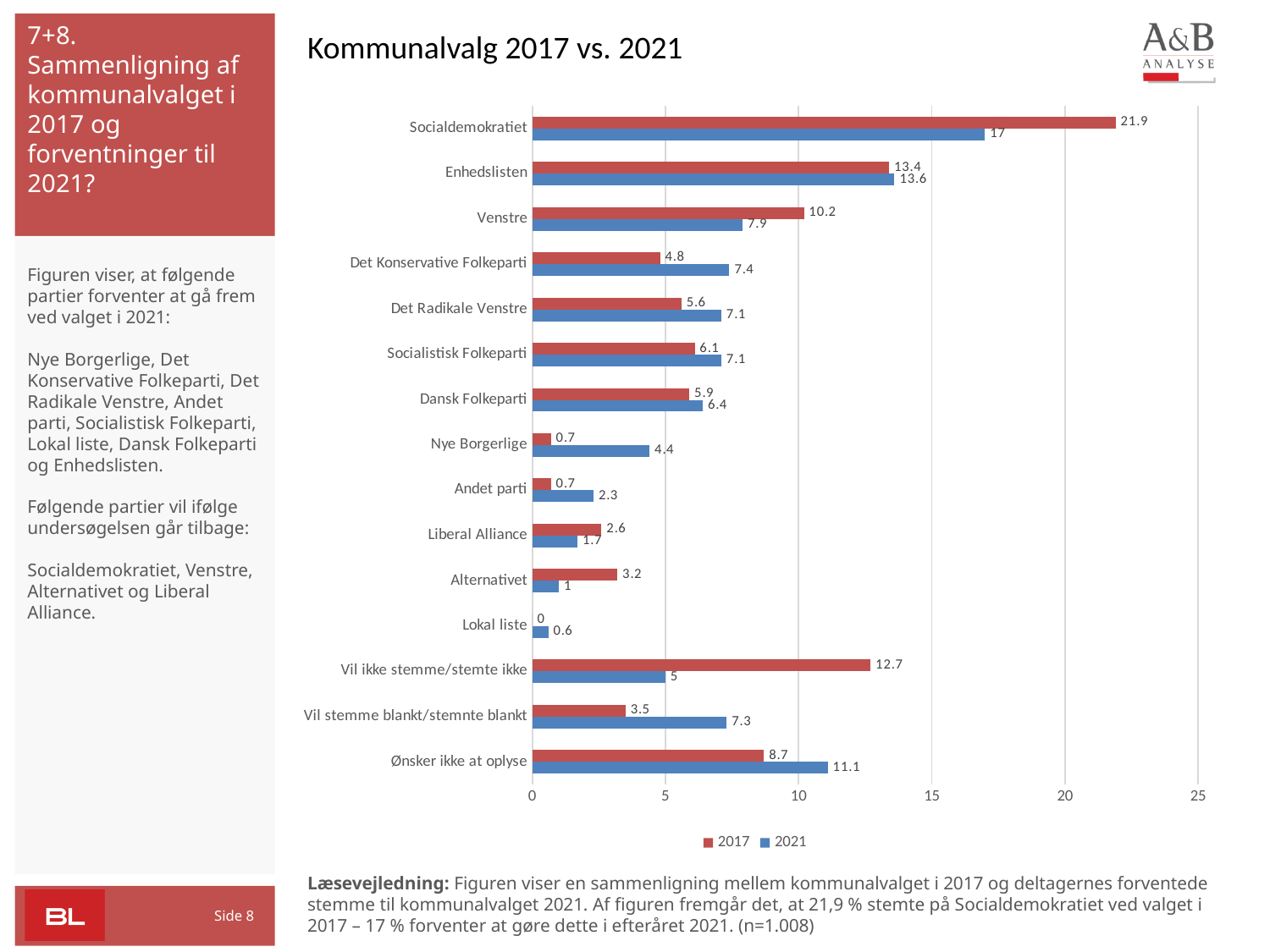
What is the 2017 value for Socialdemokratiet? 21.9 What is the 2021 value for Nye Borgerlige? 4.4 What is the title of the chart? Kommunalvalg 2017 vs. 2021 How many categories are shown on the y axis of the chart? 15 Is the 2017 value for Enhedslisten greater or less than 10? greater How many series does the legend list? 2 What is the 2021 value for Vil ikke stemme/stemte ikke? 5 Which category has the lowest 2021 value? Lokal liste Which category has the highest 2017 value? Socialdemokratiet Which is larger for Det Konservative Folkeparti, the 2017 value or the 2021 value? 2021 What is the difference between the 2017 and 2021 values for Venstre? 2.3 What kind of chart is shown on the slide? Bar chart